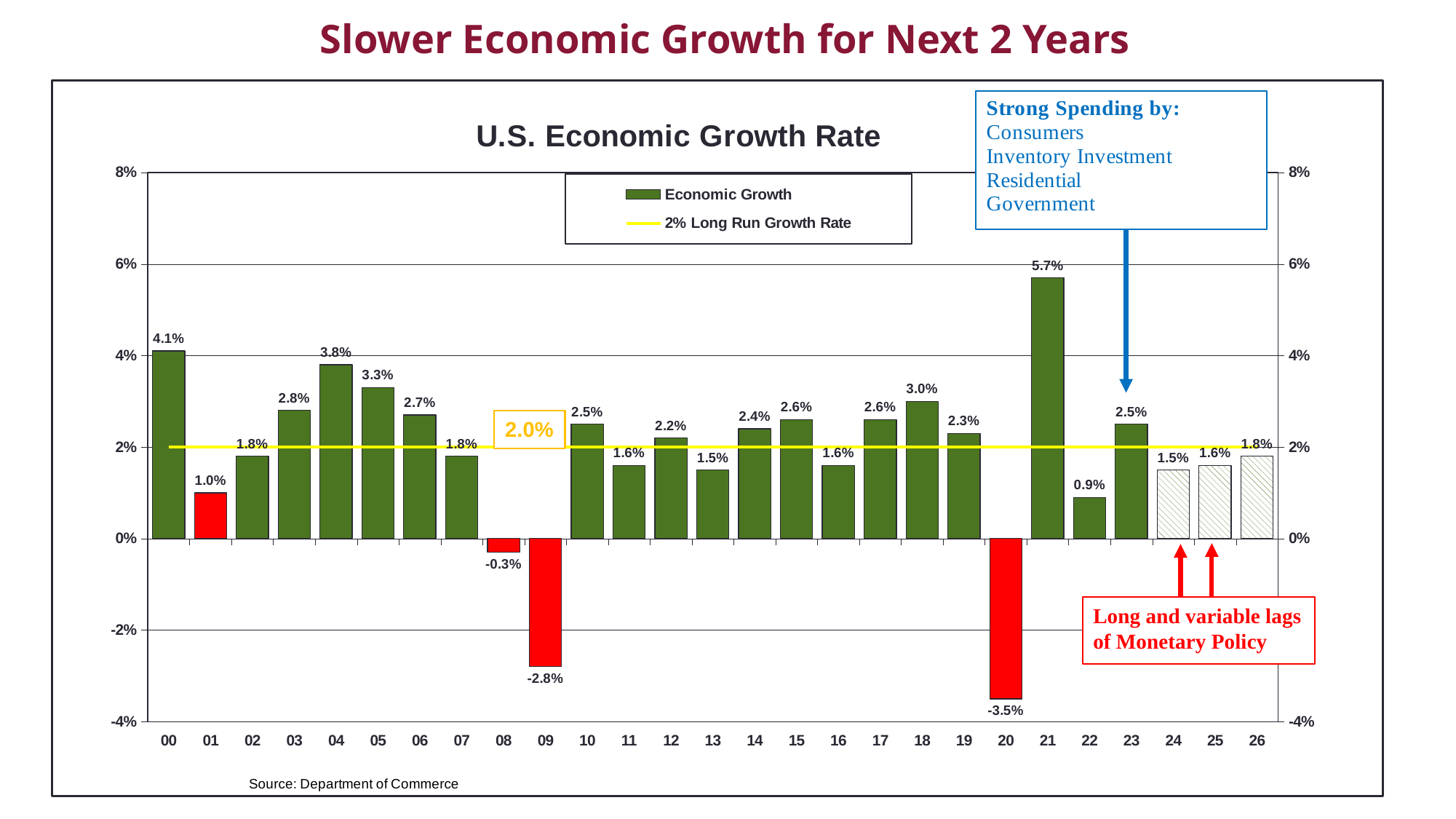
How many years (bars) are shown on the chart? 27 What is the economic growth rate shown for 2009 ("09")? -2.8% Do the growth rates rise or fall from 2024 to 2026? Rise Which year has the highest economic growth rate on the chart? 21 Which year has the lowest economic growth rate on the chart? 20 How many entries does the chart legend list? 2 What value does the yellow horizontal line on the chart represent? 2% Long Run Growth Rate What type of chart is used to show the U.S. Economic Growth Rate? Bar chart Which year has the higher growth rate, 2004 or 2005? 04 What growth rate is shown for 2026 ("26")? 1.8% What is the U.S. economic growth rate shown for 2021 ("21")? 5.7% What is the difference in percentage points between the growth rate for 2021 (5.7%) and 2020 (-3.5%)? 9.2 percentage points